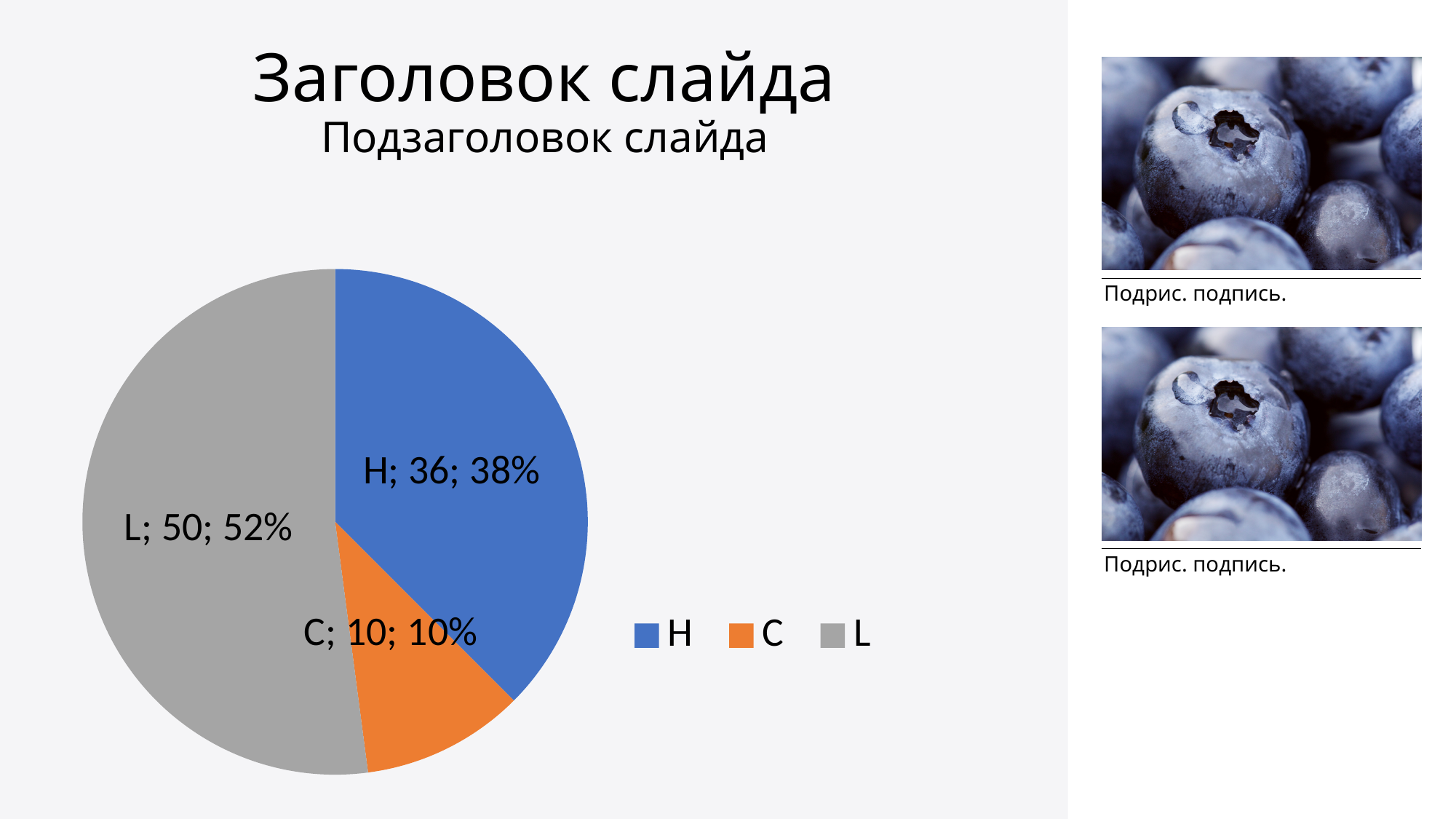
How many categories does the pie chart have? 3 What colour is the slice for C in the pie chart? orange What kind of chart is shown on the slide? pie chart What is the value for L in the pie chart? 50 Which is larger, the value for H or the value for C? H Which category has the smallest slice of the pie? C What share of the pie does L represent? 52% What is the difference between the values for L and H? 14 Which category has the largest slice of the pie? L What is the value for C in the pie chart? 10 What is the value for H in the pie chart? 36 What share of the pie does H represent? 38%